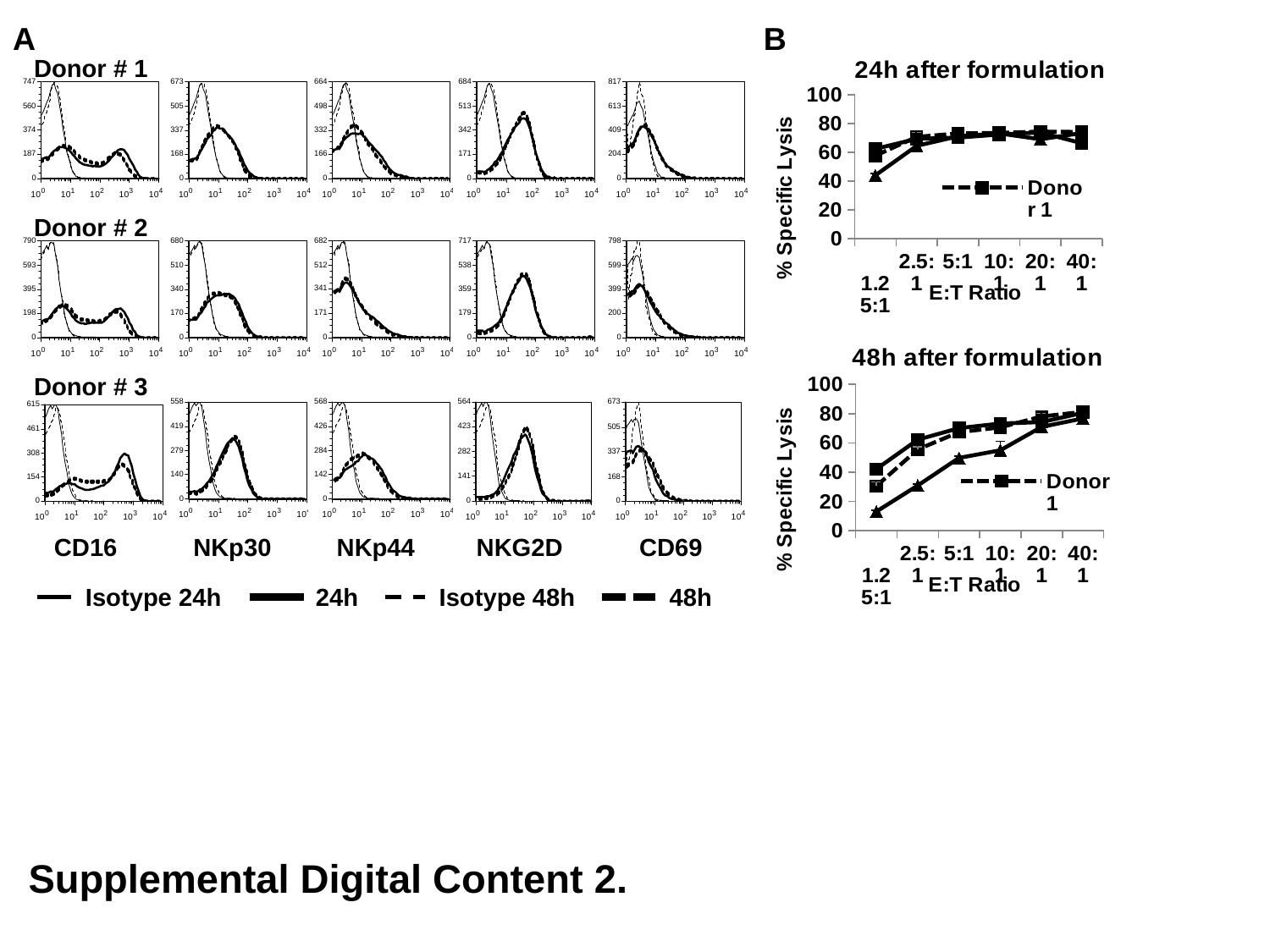
In the "48h after formulation" chart, is the value of the dashed square-marker series at the 1.25:1 E:T ratio greater or less than 40? less In the "24h after formulation" chart, is the value of the triangle-marker series at the 1.25:1 E:T ratio greater or less than 60? less What is the x-axis label of the "24h after formulation" chart? E:T Ratio In the "48h after formulation" chart, which series has the lowest value at the 1.25:1 E:T ratio: the triangle-marker series or the solid square-marker series? the triangle-marker series In the "48h after formulation" chart, is the value of the triangle-marker series at the 1.25:1 E:T ratio greater or less than 20? less How many E:T ratio categories are shown on the x axis of the "48h after formulation" chart? 6 In the "48h after formulation" chart, do the values of the triangle-marker series rise or fall as the E:T ratio increases along the x axis? rise How many entries does the legend below panel A list? 4 What kind of chart is the "24h after formulation" chart in panel B? line chart What is the y-axis label of the charts in panel B? % Specific Lysis